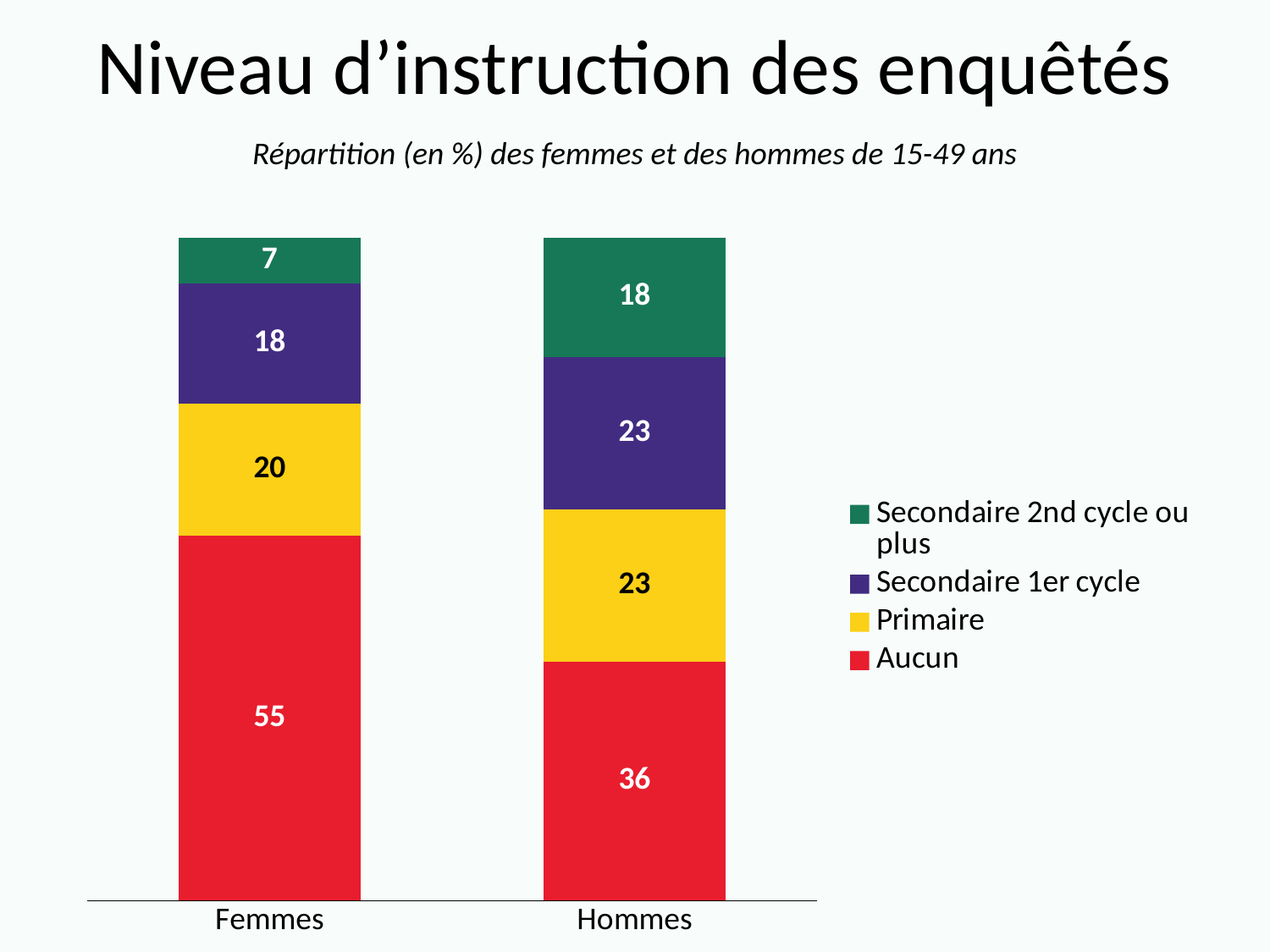
Which category has the largest value in the Femmes bar? Aucun How many series does the legend list? 4 Which category has the smallest value in the Femmes bar? Secondaire 2nd cycle ou plus What is the total of the Femmes stacked bar? 100 Which colour represents Primaire in the chart? Yellow What is the difference between the Aucun values for Femmes and Hommes? 19 What is the value for Secondaire 2nd cycle ou plus in the Femmes bar? 7 Which is larger: Secondaire 2nd cycle ou plus for Femmes or for Hommes? Hommes What is the value for Primaire in the Hommes bar? 23 What kind of chart is shown on the slide? Stacked bar chart What is the value for Secondaire 1er cycle in the Hommes bar? 23 What is the value for Aucun in the Femmes bar? 55